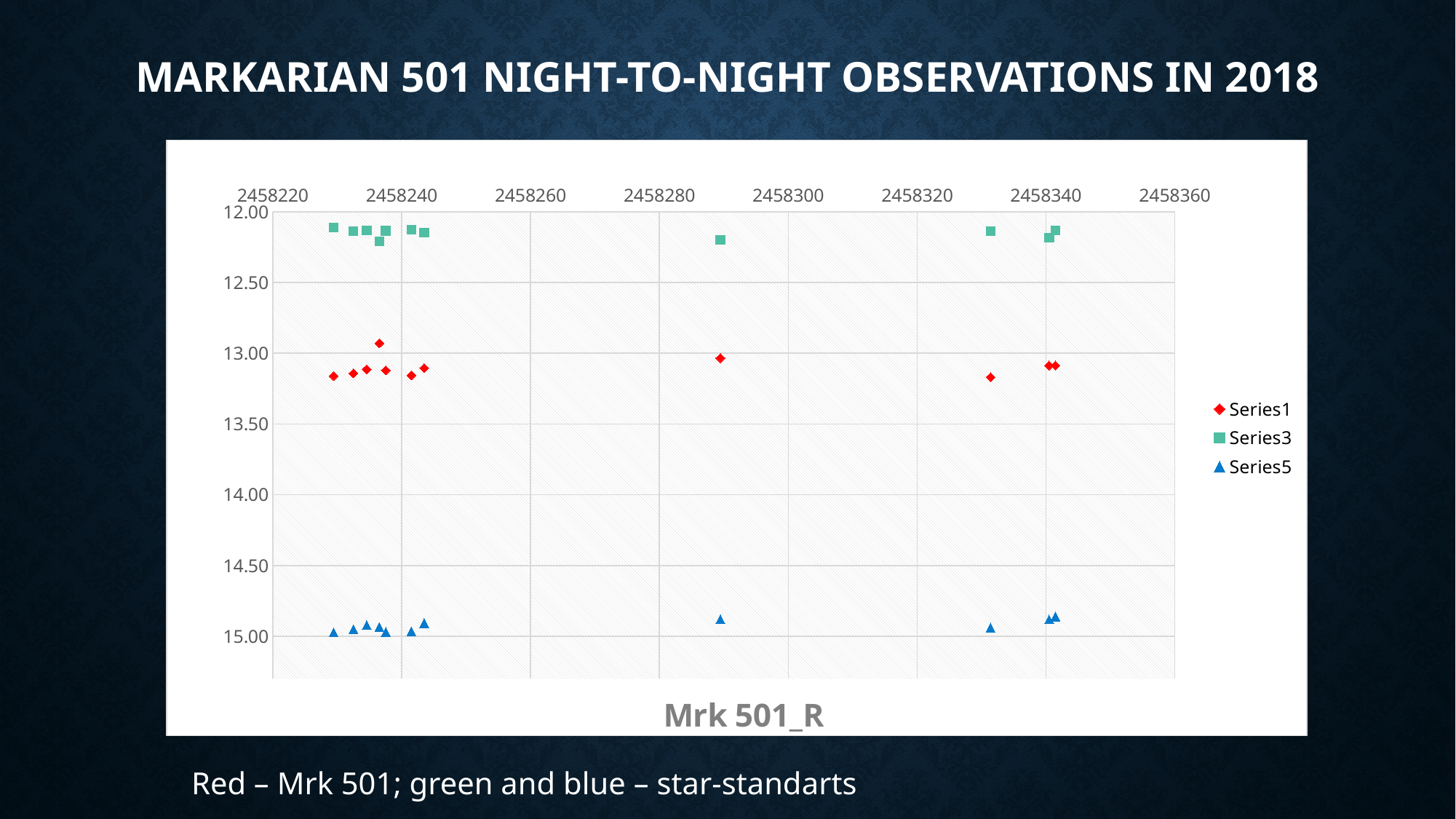
Is the Series1 value near x = 2458333 greater or less than 13.00? greater Is the Series5 value near x = 2458290 greater or less than 14.50? greater Which series has the numerically largest y-values on the chart? Series5 Is the Series1 value near x = 2458290 greater or less than 13.50? less Which series has the numerically smallest y-values on the chart? Series3 Which series has numerically larger y-values, Series1 or Series5? Series5 Which series is plotted with red diamond markers? Series1 What kind of chart is shown on the slide? scatter chart What is the title shown below the chart's plot area? Mrk 501_R Which series has numerically smaller y-values, Series1 or Series3? Series3 How many series does the legend list? 3